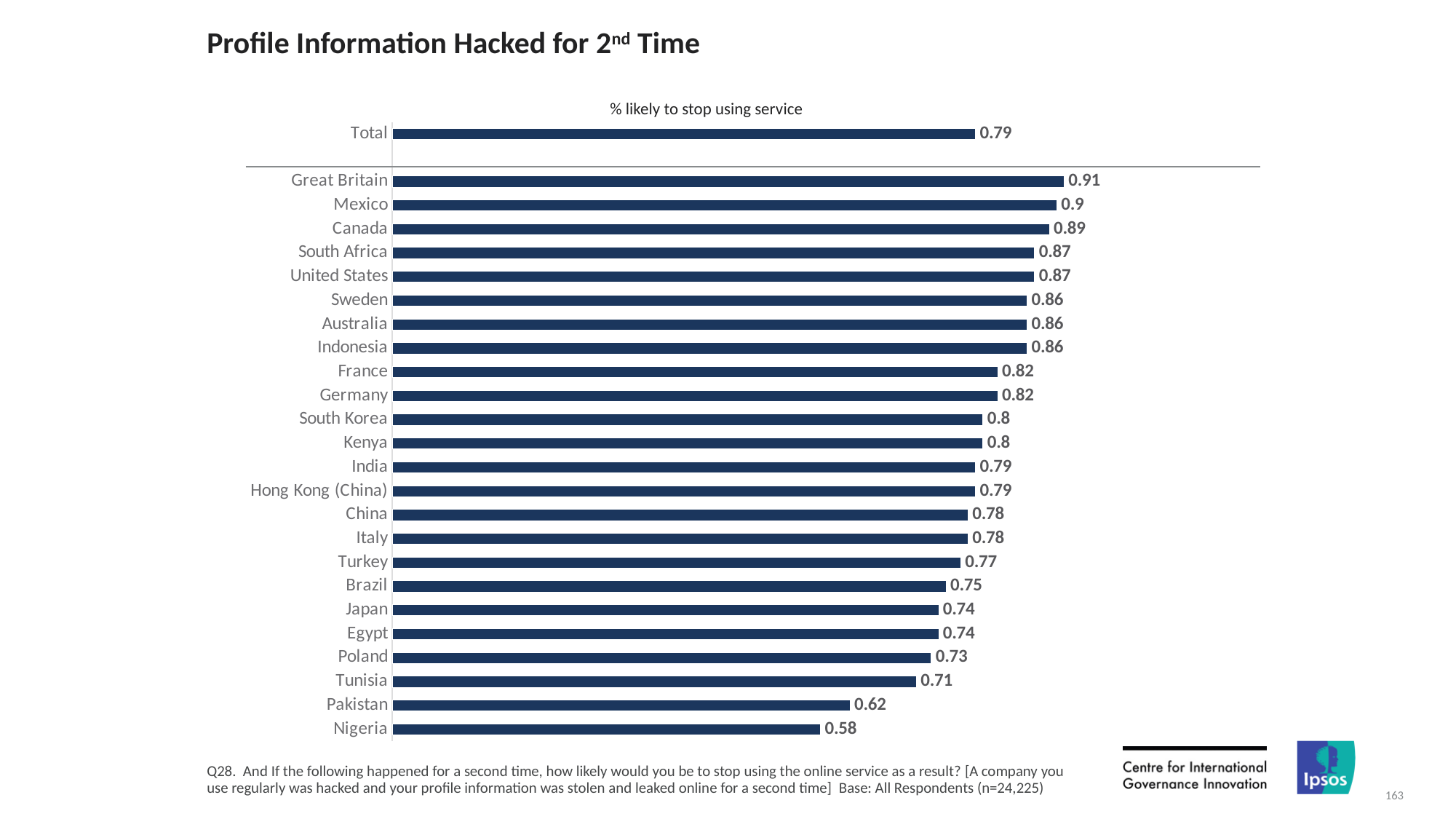
What is the difference between the values for Pakistan and Tunisia? 0.09 What is the difference between the values for Great Britain and Nigeria? 0.33 Which country has the lowest value? Nigeria Which country has the highest value? Great Britain What is the value for Nigeria? 0.58 What is the value for Total? 0.79 What is the chart's subtitle above the bars? % likely to stop using service Which has a larger value, Mexico or Brazil? Mexico What is the value for Great Britain? 0.91 What kind of chart is shown on the slide? Bar chart How many countries are listed below the Total bar? 23 What is the value for Japan? 0.74